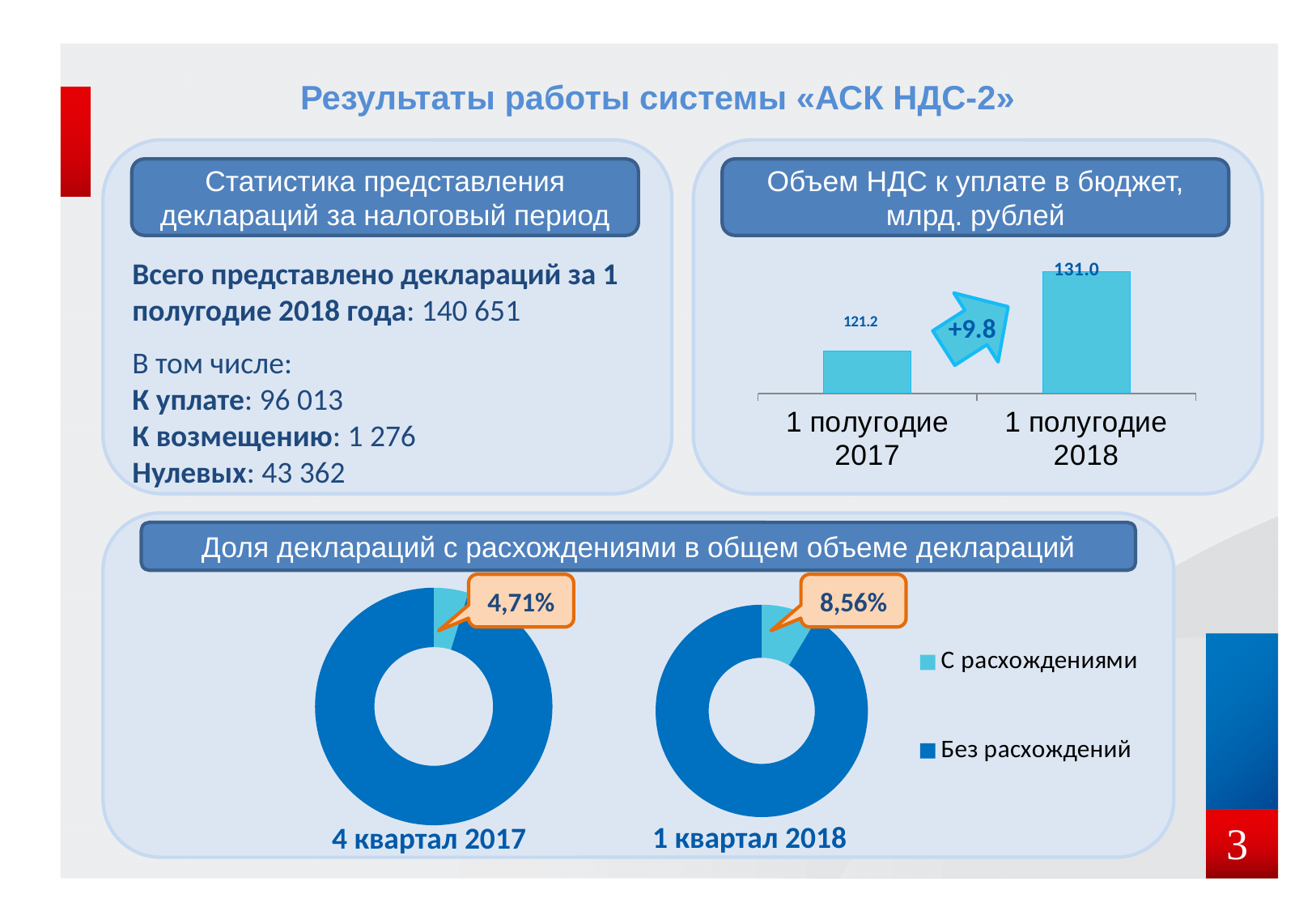
In the chart "Объем НДС к уплате в бюджет, млрд. рублей", which period has the higher value? 1 полугодие 2018 In the "Доля деклараций с расхождениями в общем объеме деклараций" charts, what is the share of "С расхождениями" for 1 квартал 2018? 8,56% In the "Доля деклараций с расхождениями в общем объеме деклараций" charts, which quarter has the larger share of "С расхождениями": 4 квартал 2017 or 1 квартал 2018? 1 квартал 2018 How many entries does the legend of the "Доля деклараций с расхождениями в общем объеме деклараций" charts list? 2 In the chart "Объем НДС к уплате в бюджет, млрд. рублей", what is the difference between 1 полугодие 2018 and 1 полугодие 2017? 9.8 In the chart "Объем НДС к уплате в бюджет, млрд. рублей", how many bars are plotted? 2 What type of chart is "Объем НДС к уплате в бюджет, млрд. рублей"? Bar chart In the "Доля деклараций с расхождениями в общем объеме деклараций" charts, what is the share of "С расхождениями" for 4 квартал 2017? 4,71% In the chart "Объем НДС к уплате в бюджет, млрд. рублей", what is the value for 1 полугодие 2017? 121.2 In the chart "Объем НДС к уплате в бюджет, млрд. рублей", do the values rise or fall from 1 полугодие 2017 to 1 полугодие 2018? Rise In the chart "Объем НДС к уплате в бюджет, млрд. рублей", what is the value for 1 полугодие 2018? 131.0 What type of chart is used for "Доля деклараций с расхождениями в общем объеме деклараций"? Donut (pie) chart